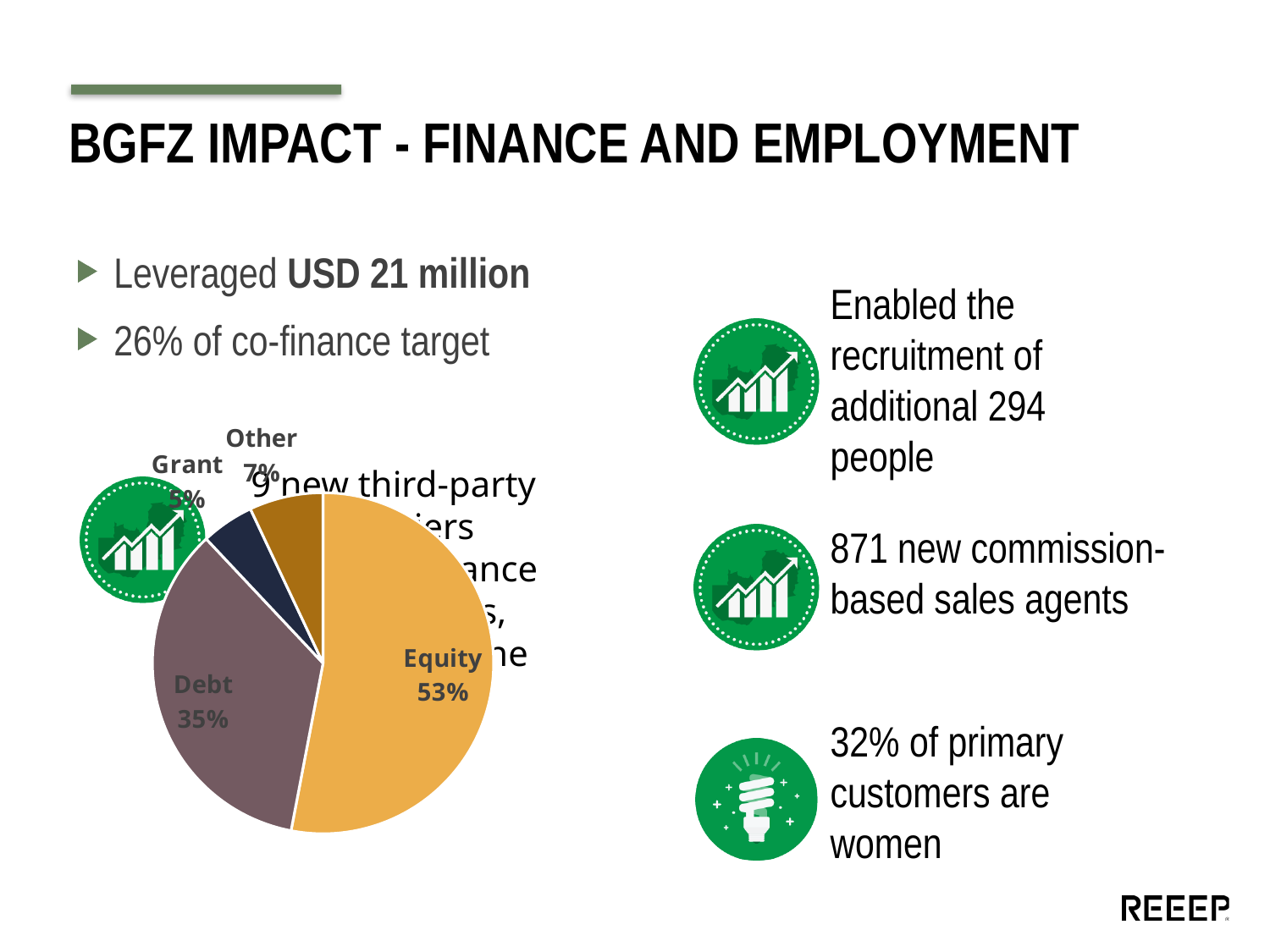
Which is larger in the pie chart, Debt or Other? Debt Which category has the largest slice in the pie chart? Equity Which category has the smallest slice in the pie chart? Grant What share of the pie chart is Equity? 53% What is the difference in percentage points between Equity and Debt in the pie chart? 18 How many slices does the pie chart have? 4 What share of the pie chart is Other? 7% What share of the pie chart is Grant? 5% What kind of chart is shown on the slide? pie chart What colour is the Equity slice in the pie chart? orange What do Equity and Debt add up to in the pie chart? 88%